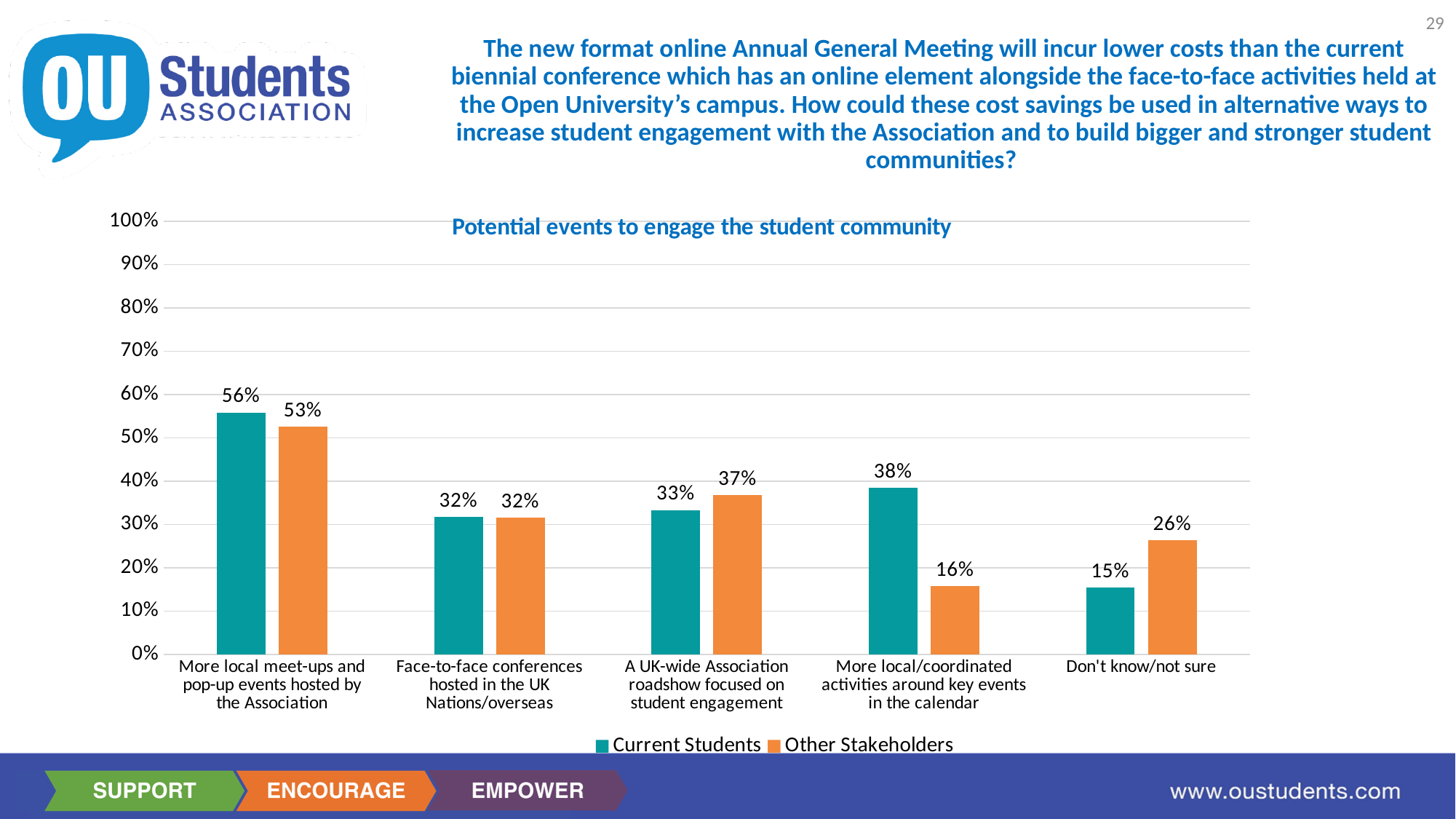
How many series does the legend list? 2 What kind of chart is shown on the slide? Bar chart What is the difference between Current Students and Other Stakeholders for 'More local/coordinated activities around key events in the calendar'? 22% Which category has the highest value for Current Students? More local meet-ups and pop-up events hosted by the Association What is the value for Other Stakeholders for 'Don't know/not sure'? 26% For 'Don't know/not sure', which series has the larger value, Current Students or Other Stakeholders? Other Stakeholders What is the value for Current Students for 'More local meet-ups and pop-up events hosted by the Association'? 56% Which category has the lowest value for Other Stakeholders? More local/coordinated activities around key events in the calendar Is the value for Current Students for 'A UK-wide Association roadshow focused on student engagement' greater or less than 40%? less How many categories are shown on the x axis? 5 What is the value for Other Stakeholders for 'A UK-wide Association roadshow focused on student engagement'? 37% What is the title of the chart? Potential events to engage the student community